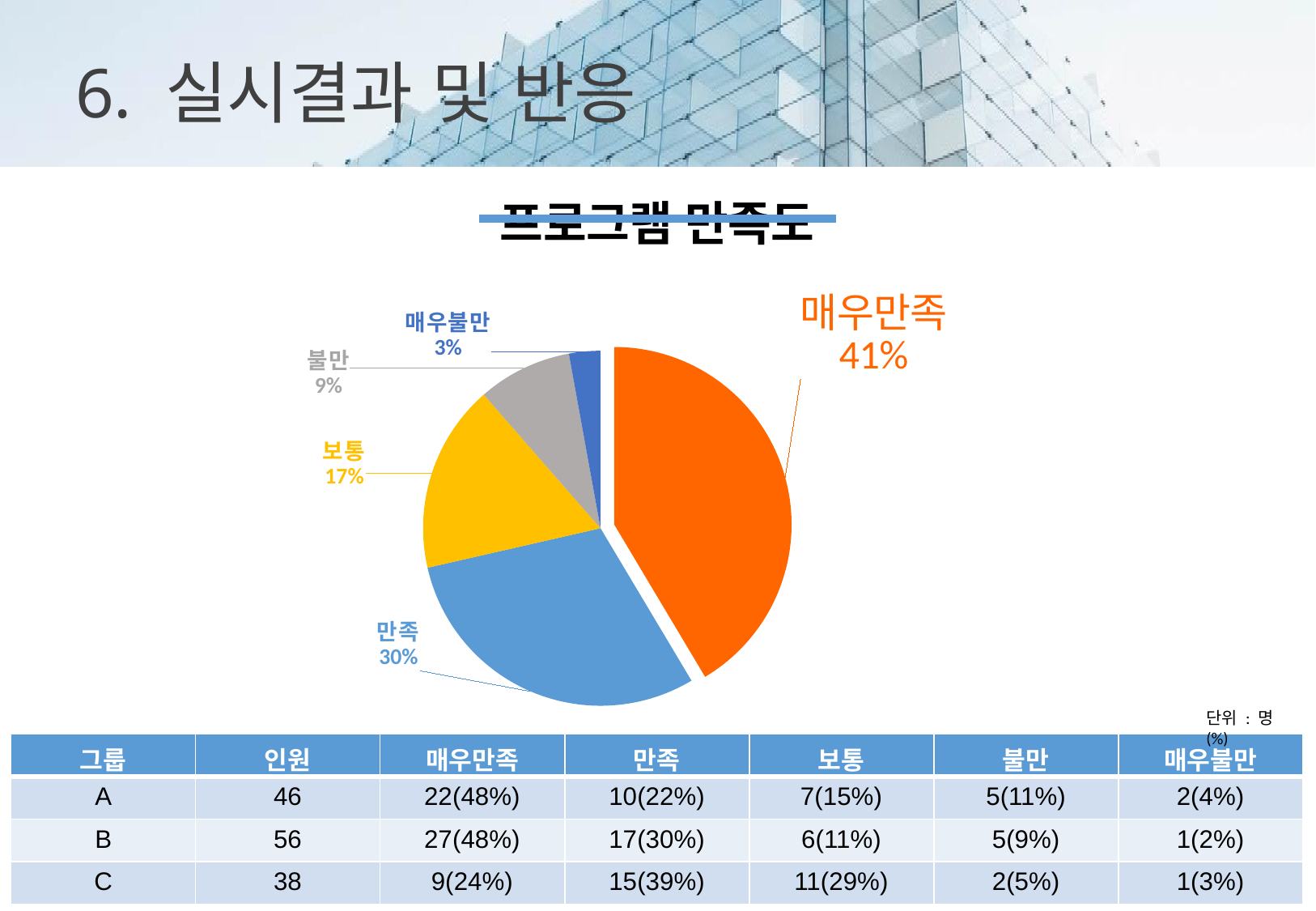
What kind of chart is shown on the slide? pie chart What share of the pie does 만족 represent? 30% Which category has the largest slice of the pie? 매우만족 What share of the pie does 보통 represent? 17% What share of the pie does 매우만족 represent? 41% Which slice is larger, 보통 or 불만? 보통 What is the title of the pie chart? 프로그램 만족도 What is the difference in percentage points between the 매우만족 and 만족 slices? 11% How many slices does the pie chart have? 5 Which category has the smallest slice of the pie? 매우불만